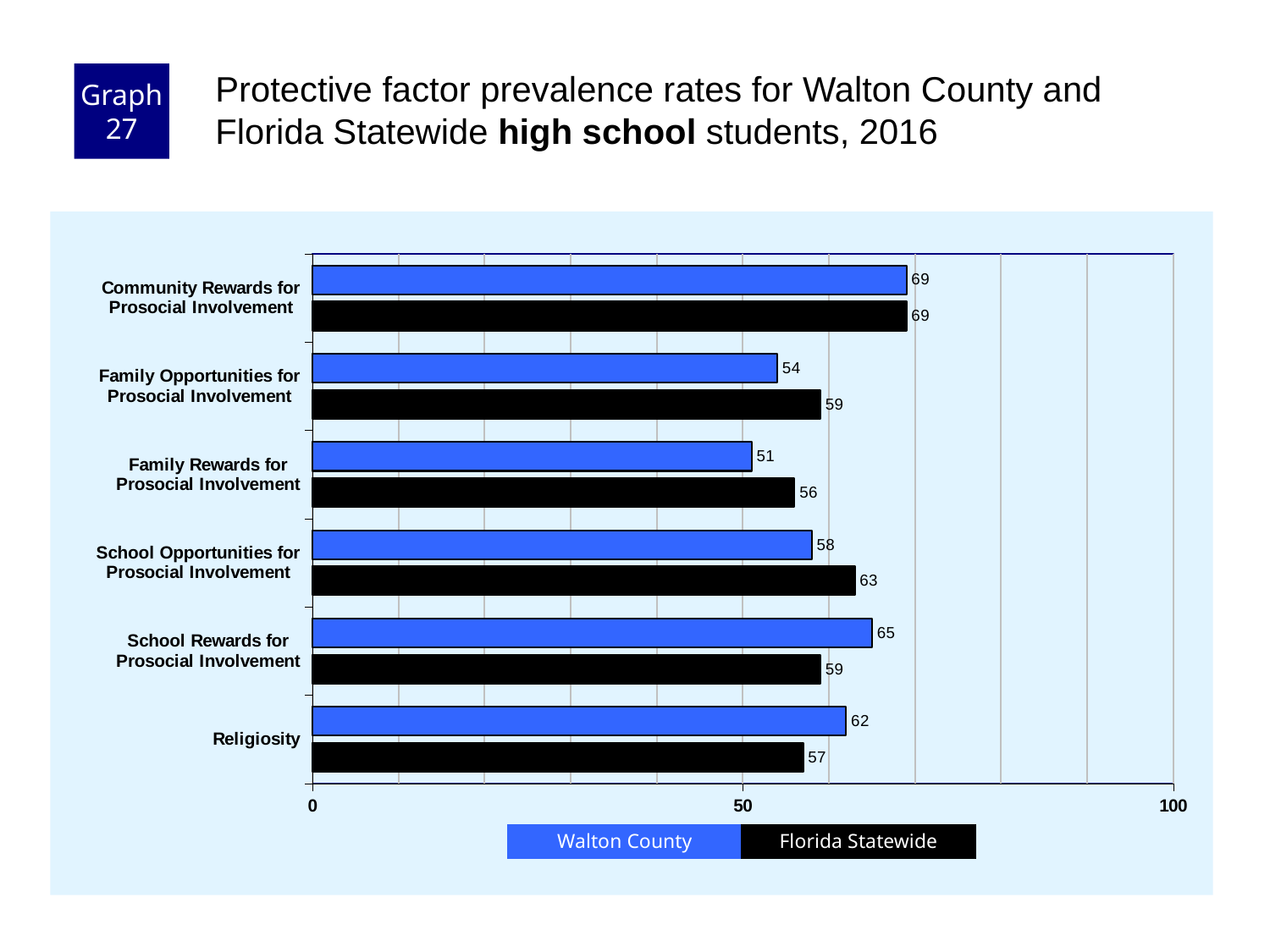
Which is larger for School Rewards for Prosocial Involvement: the Walton County value or the Florida Statewide value? Walton County What is the Florida Statewide value for School Opportunities for Prosocial Involvement? 63 Which category has the highest Walton County value? Community Rewards for Prosocial Involvement What kind of chart is shown on the slide? bar chart What is the Walton County value for Family Opportunities for Prosocial Involvement? 54 How many categories are shown on the chart? 6 What is the difference between the Florida Statewide and Walton County values for Family Rewards for Prosocial Involvement? 5 Is the Walton County value for Religiosity greater or less than 50? greater Which category has the lowest Walton County value? Family Rewards for Prosocial Involvement Which colour represents Florida Statewide in the chart? black What is the Florida Statewide value for Religiosity? 57 How many series does the legend list? 2